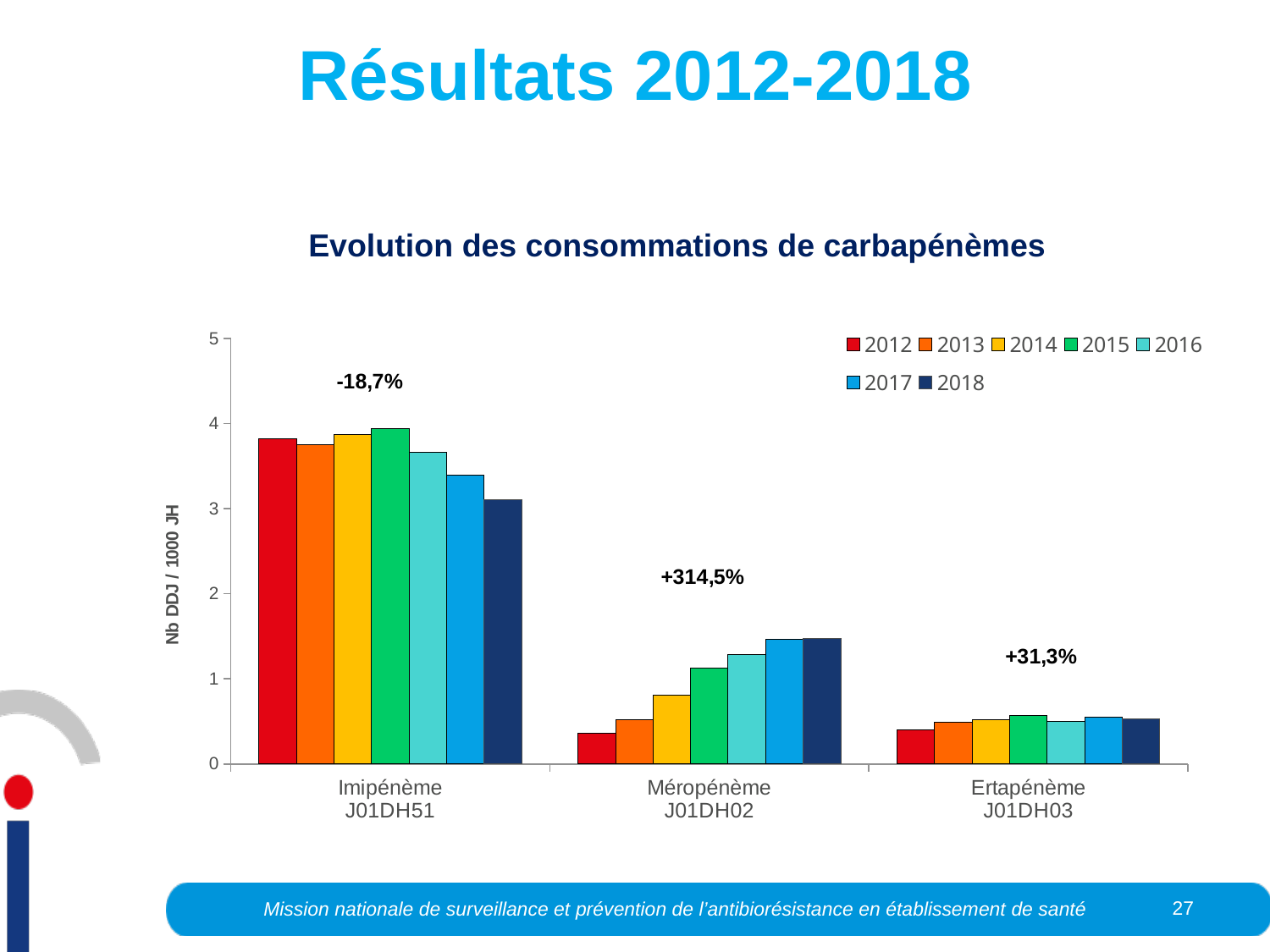
How many antibiotic categories are shown on the x axis? 3 What percentage change is printed above the Imipénème J01DH51 bars? -18,7% What kind of chart is shown on the slide? Bar chart What is the label of the y axis? Nb DDJ / 1000 JH Which year has the lowest value for Imipénème J01DH51? 2018 What percentage change is printed above the Méropénème J01DH02 bars? +314,5% What is the title of the chart? Evolution des consommations de carbapénèmes Do the values for Méropénème J01DH02 rise or fall from 2012 to 2018? Rise How many series does the legend list? 7 Is the 2012 value for Méropénème J01DH02 greater or less than 1? less Is the 2012 value for Imipénème J01DH51 greater or less than 3? greater What percentage change is printed above the Ertapénème J01DH03 bars? +31,3%